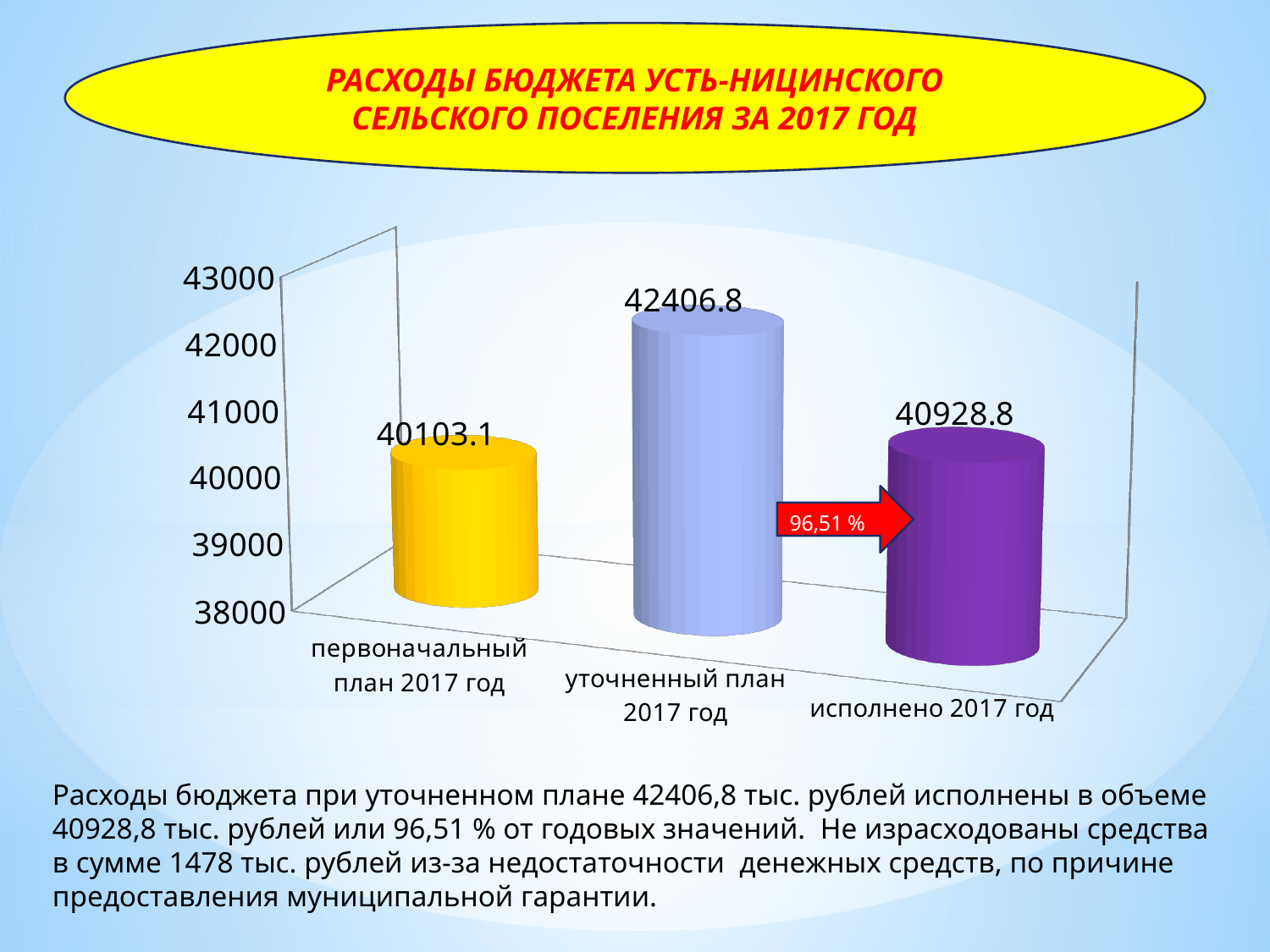
What is the value for "исполнено 2017 год"? 40928.8 What percentage is shown on the red arrow between the second and third bars? 96,51 % What is the difference between "уточненный план 2017 год" and "исполнено 2017 год"? 1478 Is the value for "уточненный план 2017 год" greater or less than 42000? greater What is the value for "первоначальный план 2017 год"? 40103.1 Which category has the lowest value? первоначальный план 2017 год What is the value for "уточненный план 2017 год"? 42406.8 What is the difference between "исполнено 2017 год" and "первоначальный план 2017 год"? 825.7 Which category has the highest value? уточненный план 2017 год What kind of chart is shown on the slide? bar chart Which is larger, the value for "исполнено 2017 год" or the value for "первоначальный план 2017 год"? исполнено 2017 год How many categories are shown on the chart? 3